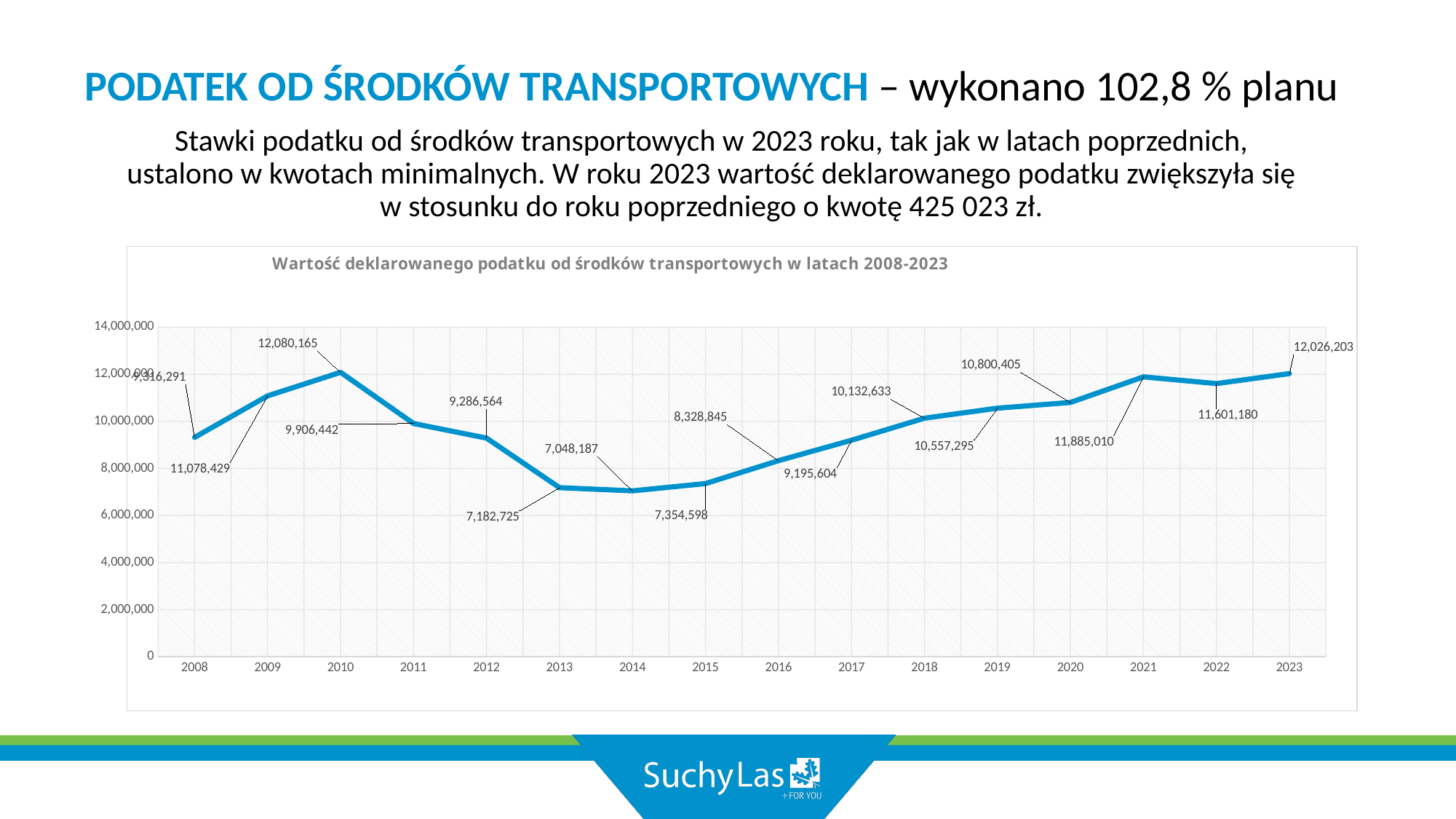
What is the value for 2023 in the chart? 12,026,203 What is the value for 2014 in the chart? 7,048,187 What is the difference between the values for 2010 and 2009? 1,001,736 How many years are plotted in the chart? 16 Which is larger, the value for 2021 or the value for 2022? 2021 Which year has the highest value in the chart? 2010 What is the difference between the values for 2023 and 2022? 425,023 Which year has the lowest value in the chart? 2014 Is the value for 2016 greater or less than 8,000,000? greater What kind of chart is shown on the slide? line chart What is the value for 2018 in the chart? 10,132,633 What is the value for 2010 in the chart? 12,080,165